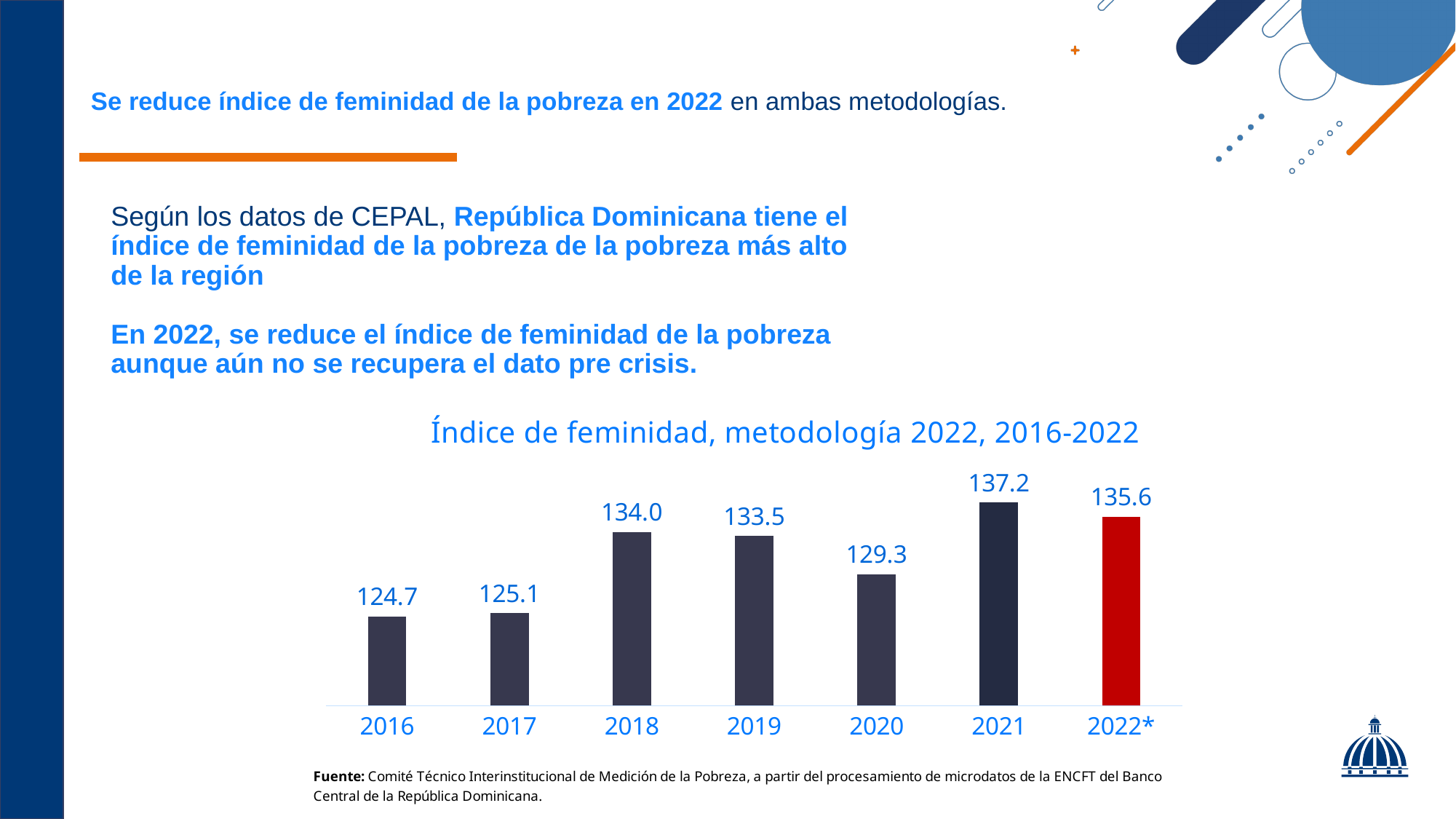
Which is larger, the value for 2018 or the value for 2019? 2018 Which year has the lowest value in the chart? 2016 Do the values rise or fall from 2019 to 2020? Fall How many years are shown in the chart? 7 Which year has the highest value in the chart? 2021 What is the difference between the values for 2021 and 2022*? 1.6 What is the difference between the values for 2018 and 2020? 4.7 What is the value for 2020 in the chart? 129.3 What is the value for 2022* in the chart? 135.6 What kind of chart is shown on the slide? Bar chart What is the title of the chart? Índice de feminidad, metodología 2022, 2016-2022 What is the value for 2016 in the chart? 124.7